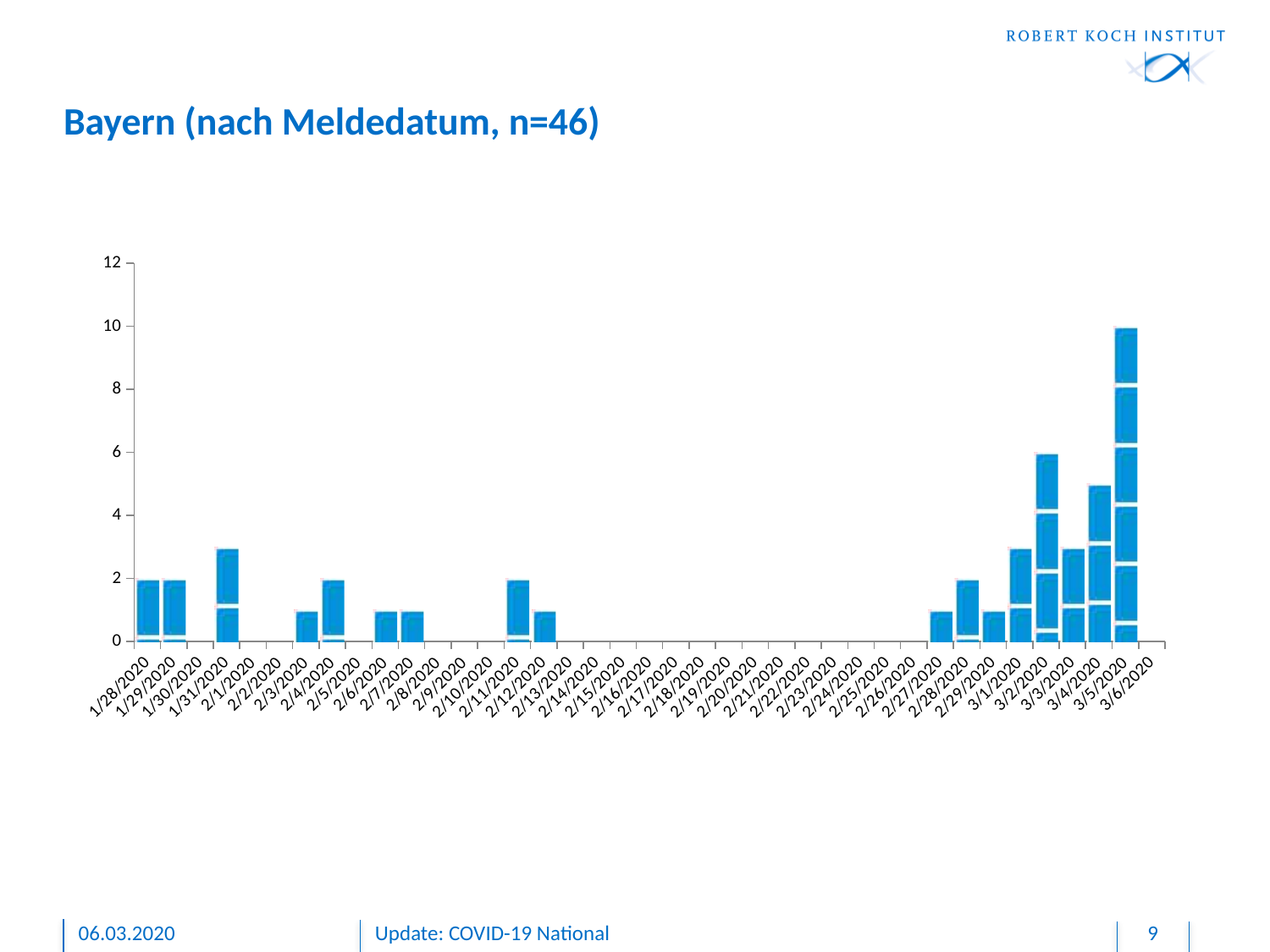
What is the value for 3/2/2020? 6 Is the value for 2/3/2020 greater or less than 2? less Which is larger, the value for 3/5/2020 or the value for 3/2/2020? 3/5/2020 What type of chart is shown on the slide? bar chart How many dates are shown on the x axis? 39 Do the values generally rise or fall from 2/27/2020 to 3/5/2020? rise Is the value for 1/31/2020 greater or less than 2? greater What is the value for 1/28/2020? 2 Which date has the highest value in the chart? 3/5/2020 Is the value for 3/4/2020 greater or less than 4? greater What is the title of the chart? Bayern (nach Meldedatum, n=46) What is the value for 3/5/2020? 10